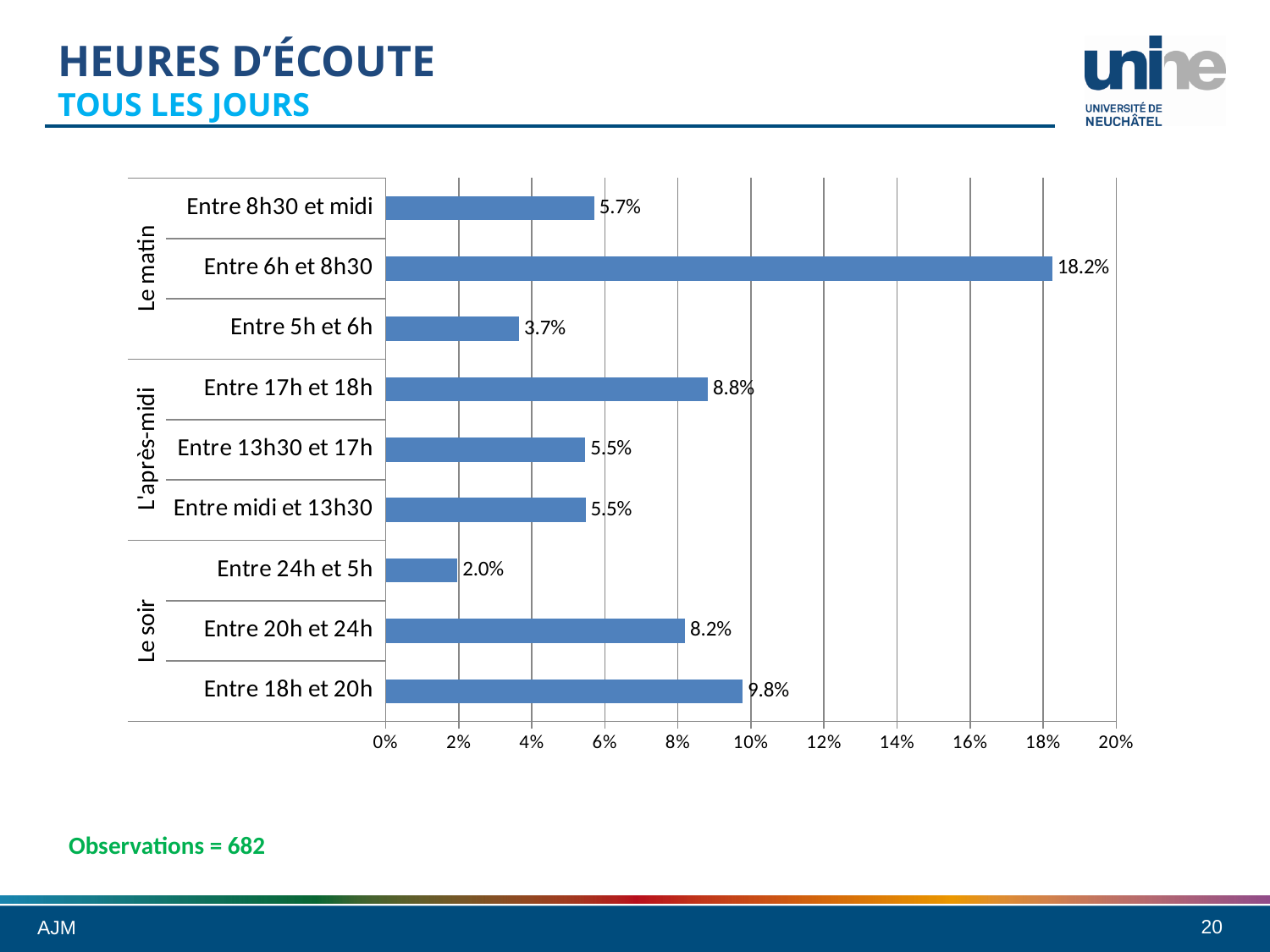
Which is larger, the value for "Entre 20h et 24h" or the value for "Entre 17h et 18h"? Entre 17h et 18h Which time slot has the highest value? Entre 6h et 8h30 What are the three group labels on the vertical axis of the chart? Le matin, L'après-midi, Le soir What is the value for "Entre 18h et 20h"? 9.8% What is the value for "Entre 6h et 8h30"? 18.2% What is the difference between the values for "Entre 6h et 8h30" and "Entre 18h et 20h"? 8.4% Is the value for "Entre 5h et 6h" greater or less than 4%? less What is the value for "Entre 17h et 18h"? 8.8% How many time slots are shown in the chart? 9 What kind of chart is shown on the slide? bar chart What is the value for "Entre 24h et 5h"? 2.0% Which time slot has the lowest value? Entre 24h et 5h